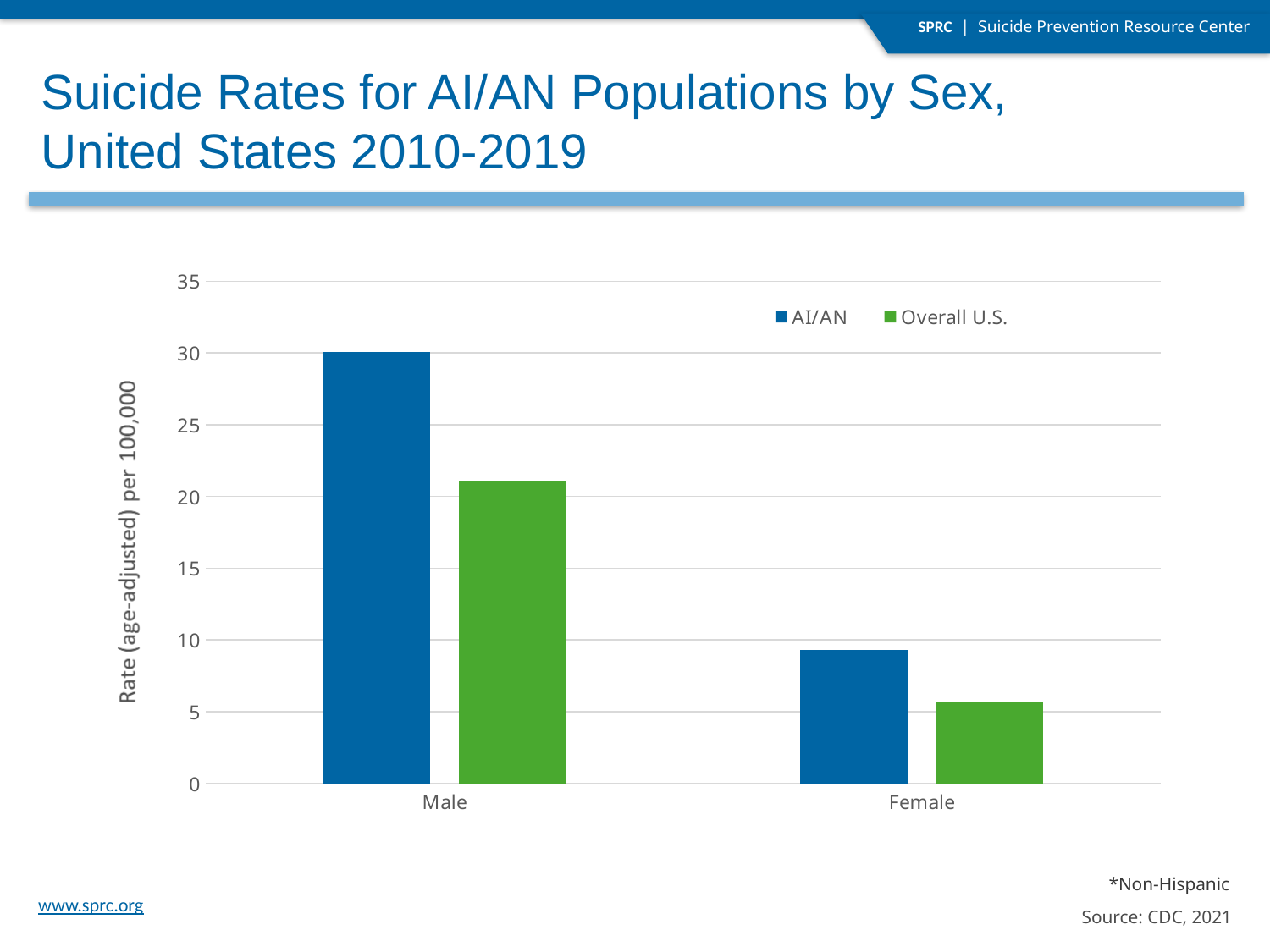
Is the Overall U.S. rate for Female greater or less than 5? greater How many series does the legend list? 2 For Female, which is larger: the AI/AN rate or the Overall U.S. rate? AI/AN What are the two series named in the legend? AI/AN and Overall U.S. Which category has the lowest Overall U.S. suicide rate? Female Which category has the highest AI/AN suicide rate? Male What is the label of the y axis? Rate (age-adjusted) per 100,000 Is the AI/AN rate for Male greater or less than 25? greater Is the Overall U.S. rate for Male greater or less than 25? less How many categories are shown on the x axis? 2 What kind of chart is shown on the slide? bar chart